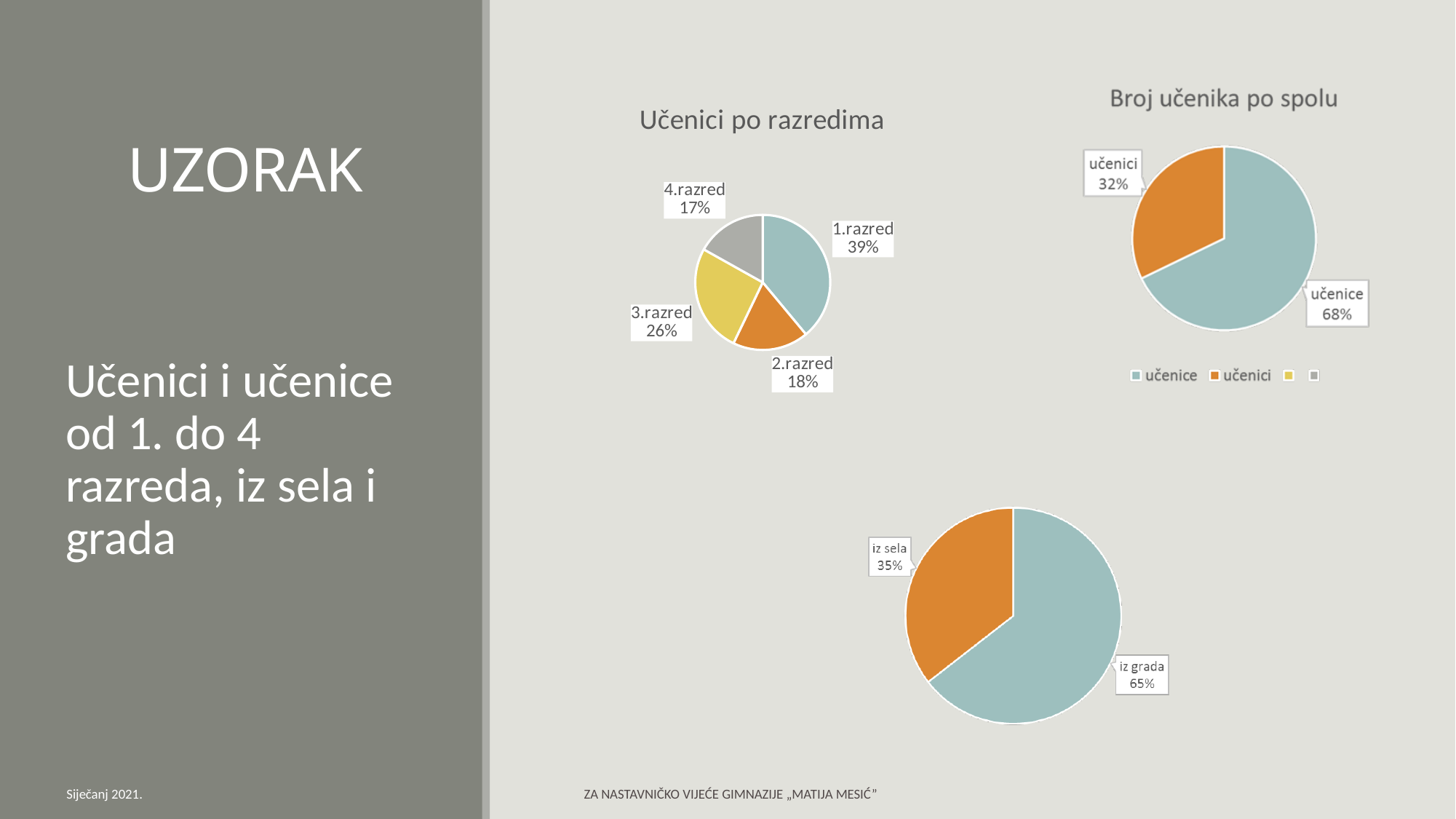
What type of chart is 'Učenici po razredima'? Pie chart In the 'Učenici po razredima' chart, what share of students is in 1.razred? 39% In the bottom pie chart, what is the difference in percentage points between 'iz grada' and 'iz sela'? 30 In the 'Broj učenika po spolu' chart, which group is larger, učenice or učenici? učenice In the 'Učenici po razredima' chart, which grade has the smallest share? 4.razred In the 'Broj učenika po spolu' chart, what share is učenici? 32% In the 'Učenici po razredima' chart, what is the difference in percentage points between 1.razred and 2.razred? 21 In the 'Učenici po razredima' chart, which grade has the largest share? 1.razred In the 'Broj učenika po spolu' chart, what share is učenice? 68% In the 'Učenici po razredima' chart, how many grades (slices) are shown? 4